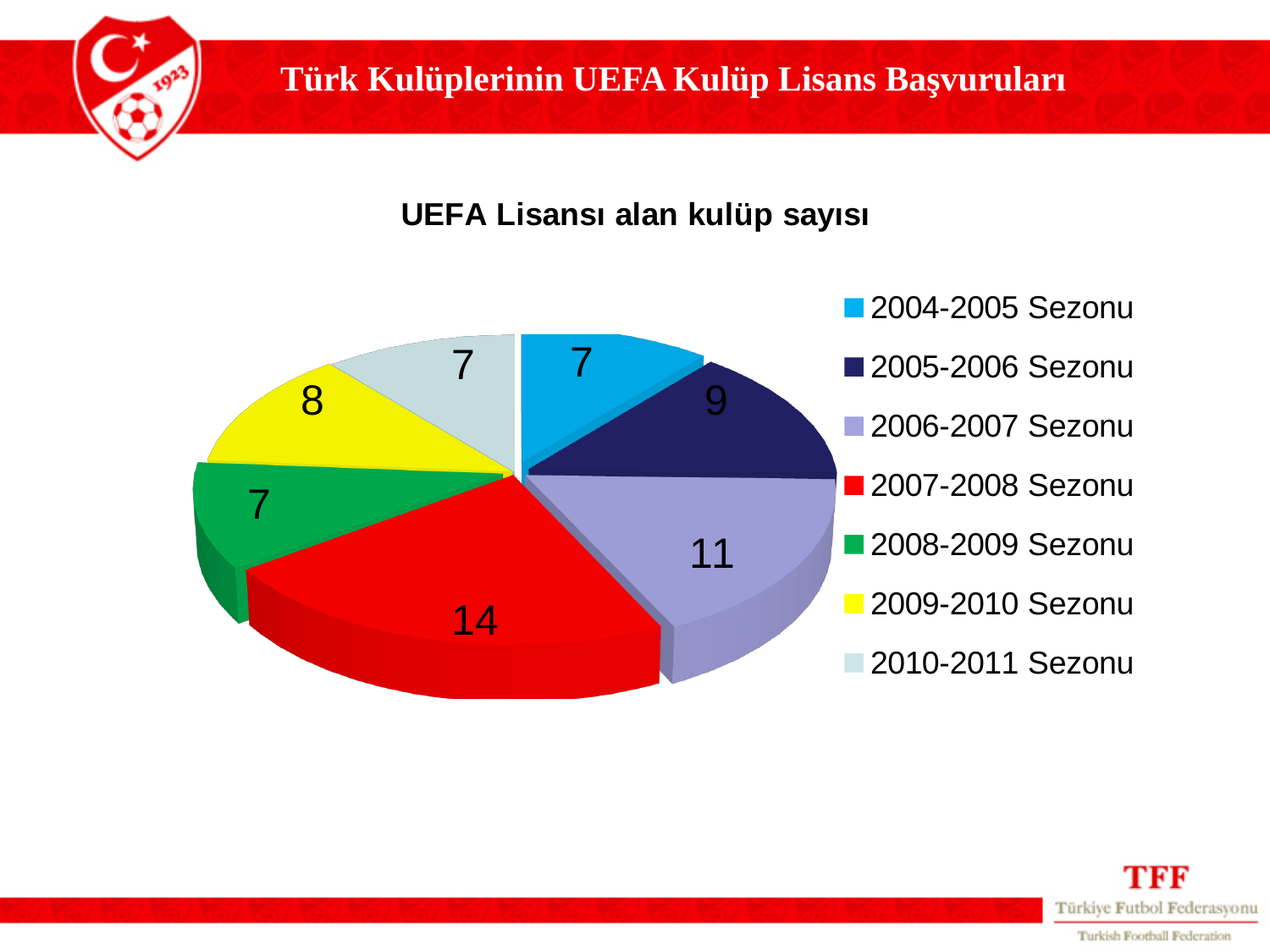
Which season has the largest slice of the pie? 2007-2008 Sezonu What is the title of the chart? UEFA Lisansı alan kulüp sayısı What is the total of all the slices in the pie chart? 63 What is the value for the 2009-2010 Sezonu slice? 8 What kind of chart is shown on the slide? Pie chart What is the value for the 2005-2006 Sezonu slice? 9 Which is larger, the value for 2005-2006 Sezonu or 2009-2010 Sezonu? 2005-2006 Sezonu What is the value for the 2006-2007 Sezonu slice? 11 How many seasons (slices) does the pie chart show? 7 Which colour represents the 2008-2009 Sezonu in the legend? Green How many clubs received a UEFA licence in the 2007-2008 Sezonu? 14 What is the difference between the values for 2007-2008 Sezonu and 2006-2007 Sezonu? 3